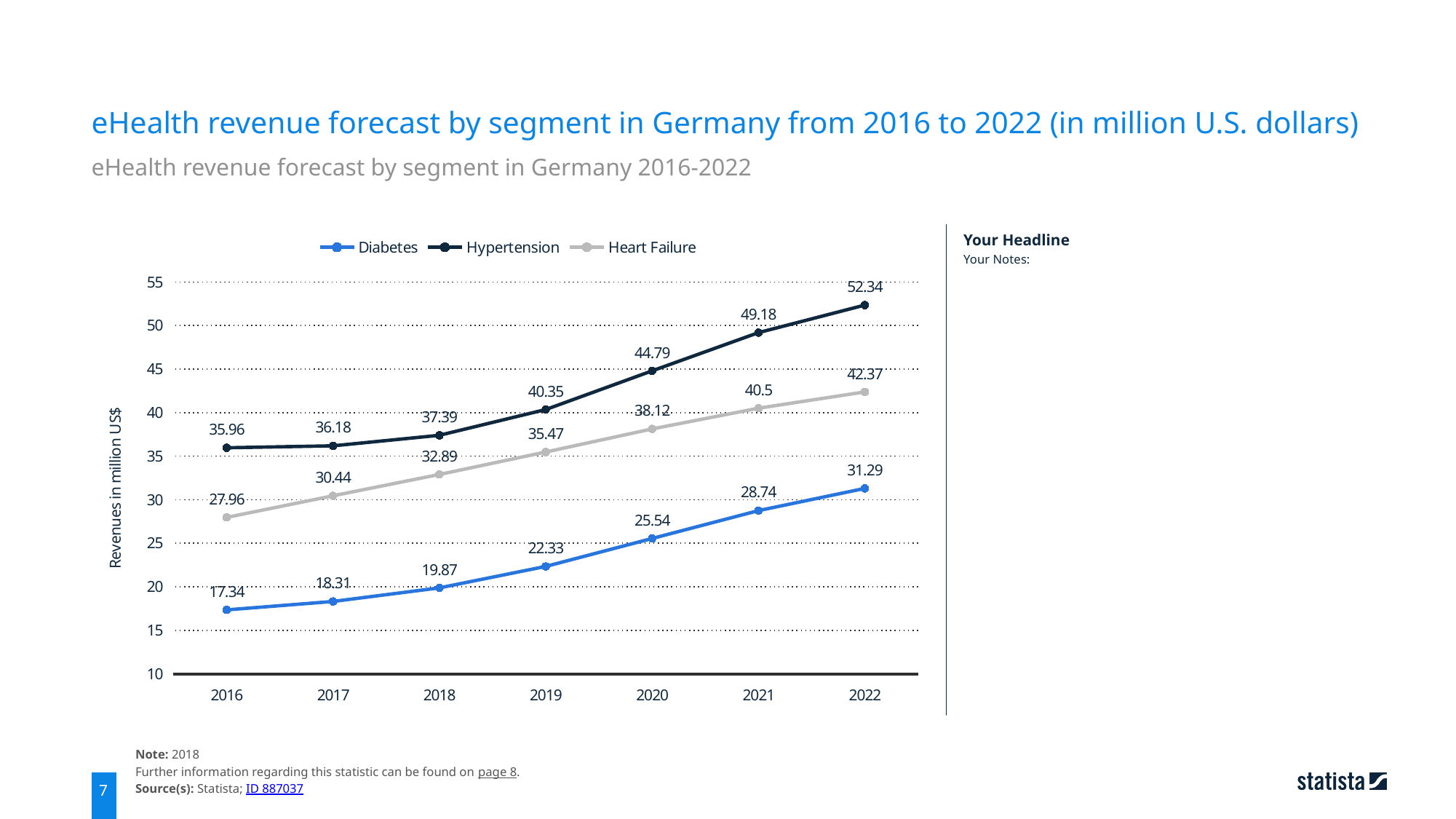
Is the Hypertension forecast for 2019 greater or less than 45? less What is the Heart Failure revenue forecast for 2019? 35.47 How many years are shown on the x axis? 7 In which year is the Heart Failure revenue forecast lowest? 2016 Which is larger in 2021: the Heart Failure forecast or the Diabetes forecast? Heart Failure What is the Hypertension revenue forecast for 2022? 52.34 Does the Diabetes series rise or fall from 2016 to 2022? rise How many series does the legend list? 3 What kind of chart is shown on the slide? line chart In which year is the Diabetes revenue forecast highest? 2022 What is the Diabetes revenue forecast for 2016? 17.34 What is the difference between the Hypertension and Diabetes forecasts for 2020? 19.25